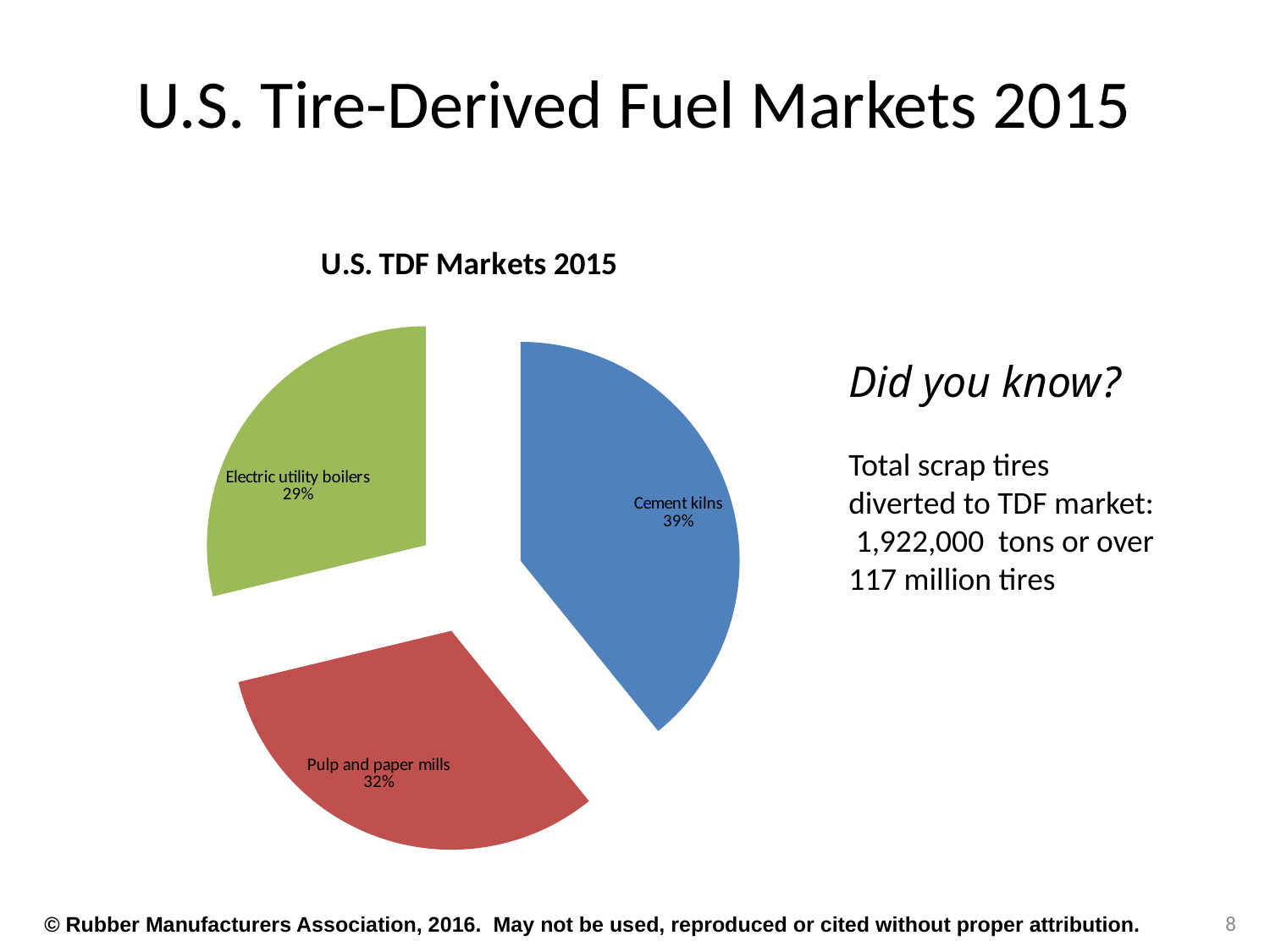
Which category has the smallest share of the pie? Electric utility boilers What kind of chart is shown on the slide? Pie chart What share of the pie does Cement kilns have? 39% What share of the pie does Pulp and paper mills have? 32% What is the difference in percentage points between Pulp and paper mills and Electric utility boilers? 3 Which has a larger share, Pulp and paper mills or Cement kilns? Cement kilns What is the title of the chart? U.S. TDF Markets 2015 What colour is the Pulp and paper mills slice? Red What share of the pie does Electric utility boilers have? 29% Which category has the largest share of the pie? Cement kilns What is the difference in percentage points between Cement kilns and Electric utility boilers? 10 How many categories are shown in the pie chart? 3